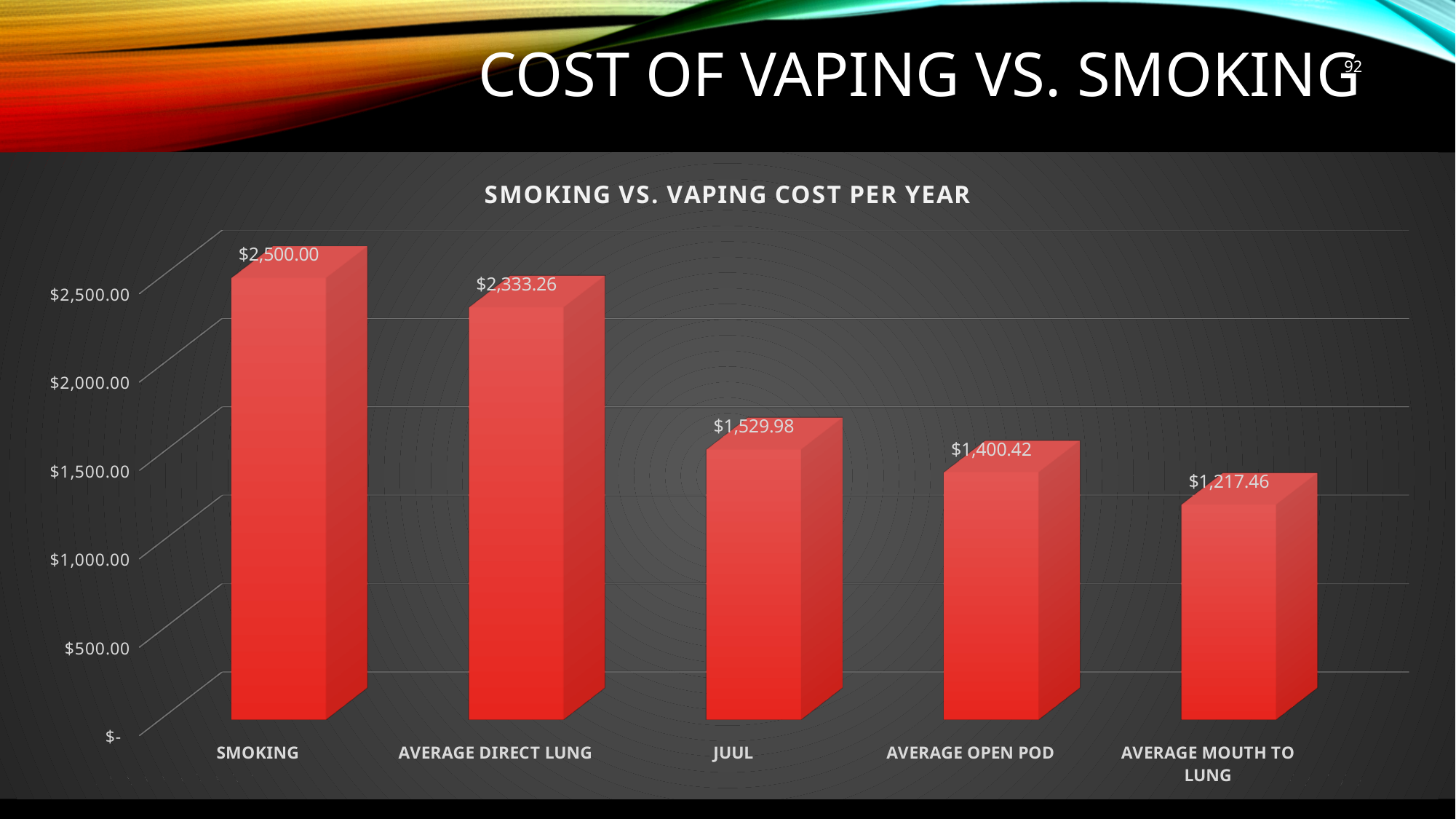
Which category has the highest cost per year? Smoking What is the cost per year for JUUL? $1,529.98 What is the cost per year for Smoking? $2,500.00 Which has a higher cost per year, JUUL or Average Open Pod? JUUL What is the difference in cost per year between JUUL and Average Open Pod? $129.56 What is the title of the chart? Smoking vs. Vaping Cost Per Year What is the cost per year for Average Direct Lung? $2,333.26 What is the difference in cost per year between Smoking and Average Direct Lung? $166.74 Which category has the lowest cost per year? Average Mouth to Lung What is the cost per year for Average Mouth to Lung? $1,217.46 How many categories are shown in the chart? 5 What kind of chart is shown on the slide? Bar chart